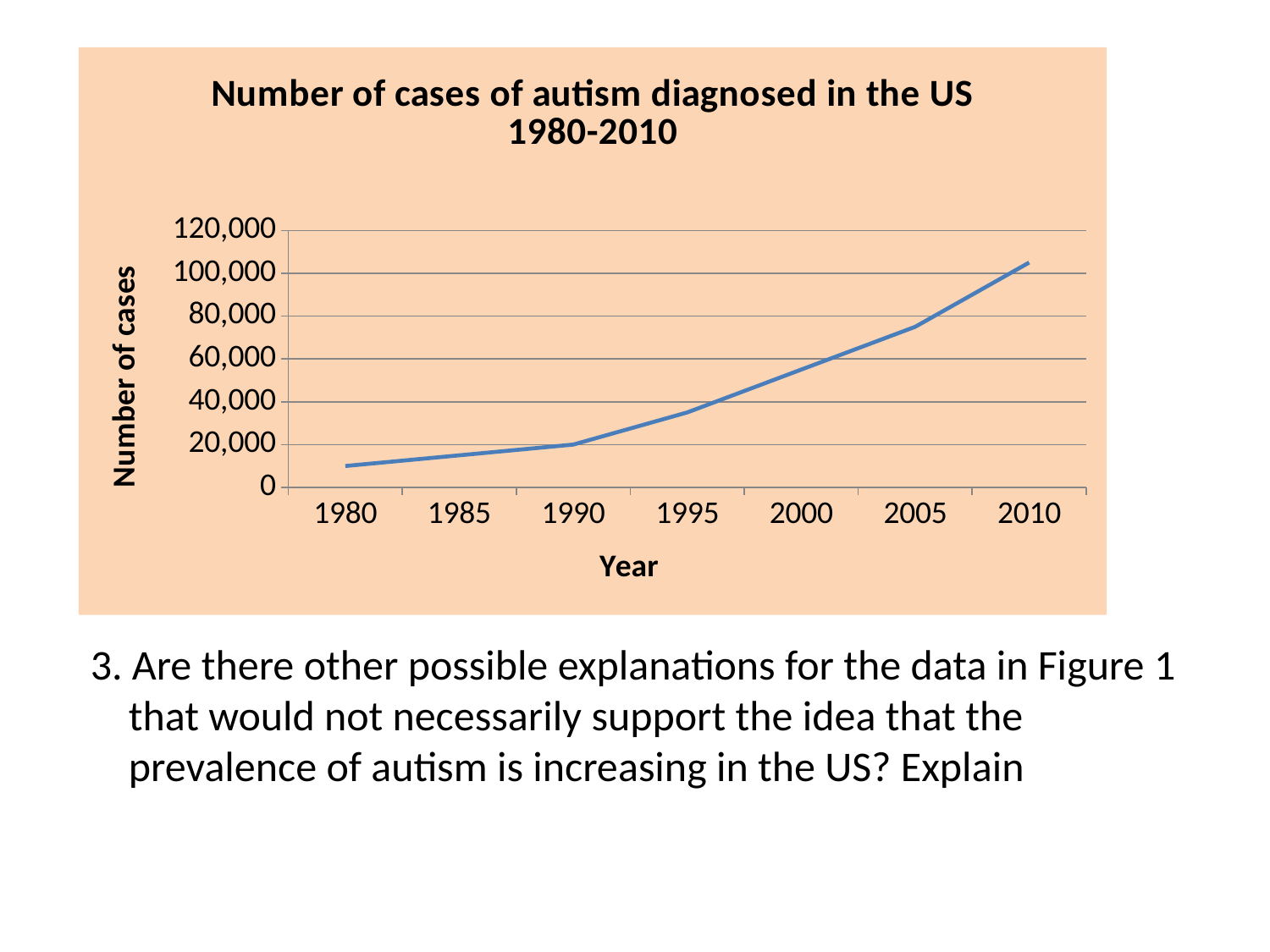
Which year has the lowest number of cases? 1980 What kind of chart is shown on the slide? line chart How many years are marked on the x axis? 7 Which year has the highest number of cases? 2010 Is the value for 1995 greater or less than 20,000? greater Do the values rise or fall from 1980 to 2010? rise What is the title of the chart? Number of cases of autism diagnosed in the US 1980-2010 Which is larger, the value for 2005 or the value for 1995? 2005 Is the value for 2000 greater or less than 40,000? greater Is the value for 2010 greater or less than 100,000? greater What is the label of the vertical axis? Number of cases